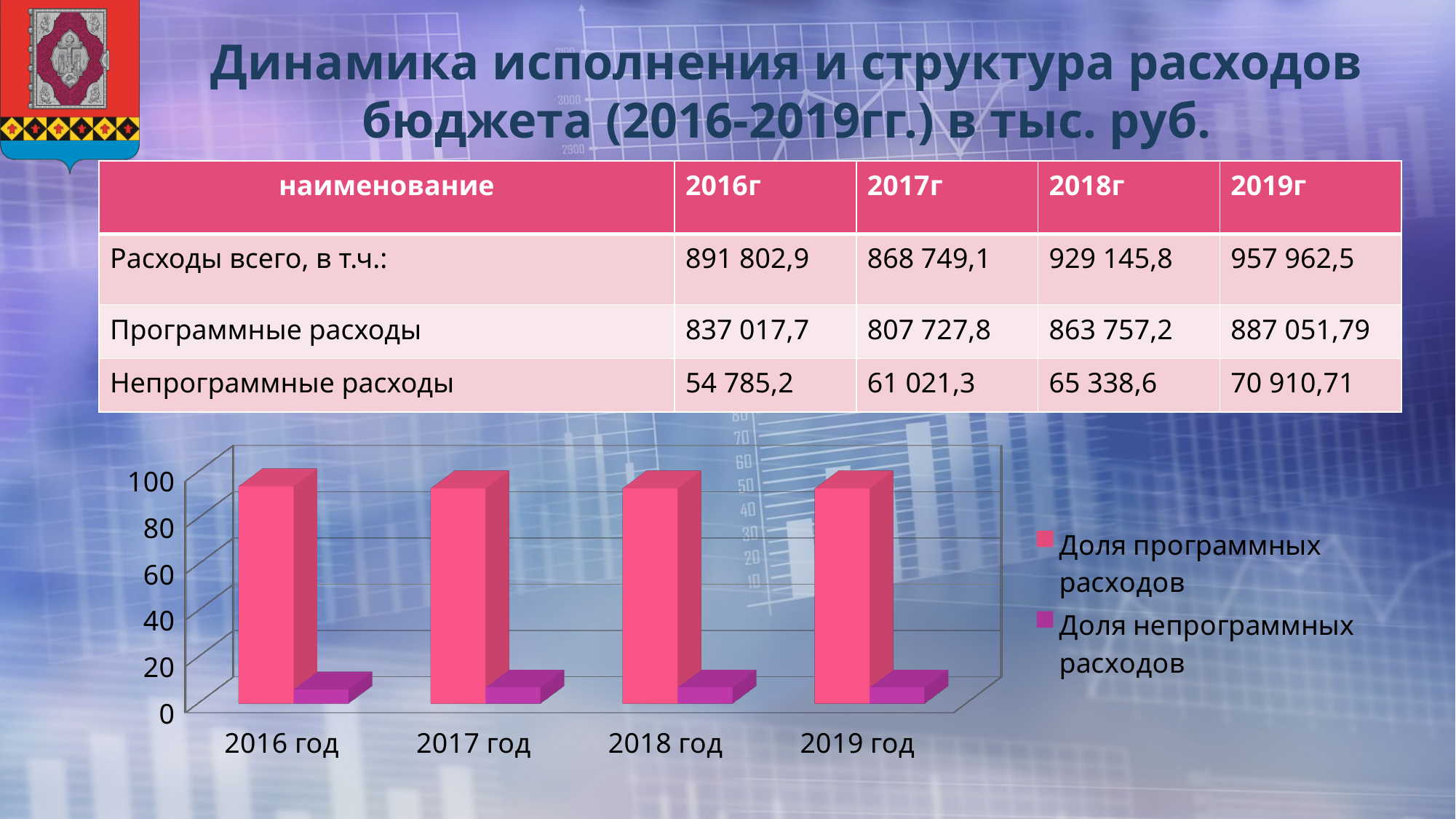
What kind of chart is shown on the slide? bar chart In 2017 год, which series has the smaller value: Доля программных расходов or Доля непрограммных расходов? Доля непрограммных расходов How many years (categories) are shown on the x axis of the chart? 4 Is the value for Доля программных расходов in 2016 год greater or less than 80? greater What is the first category label on the x axis of the chart? 2016 год How many series does the chart legend list? 2 Is the value for Доля программных расходов in 2019 год greater or less than 60? greater Is the value for Доля непрограммных расходов in 2018 год greater or less than 40? less Which series in the chart is shown in the darker purple colour? Доля непрограммных расходов In 2018 год, which series has the larger value: Доля программных расходов or Доля непрограммных расходов? Доля программных расходов